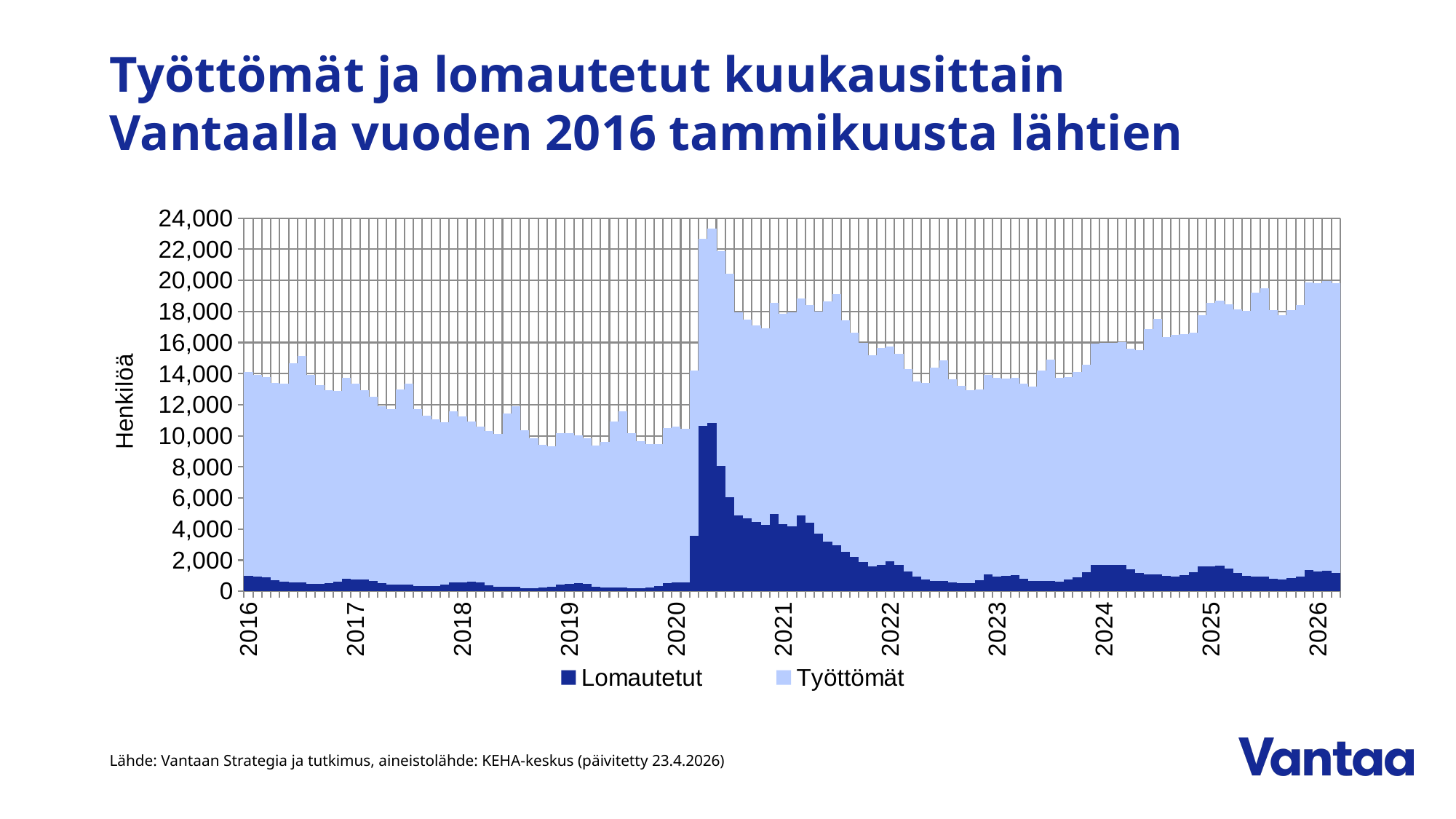
Is the value for Lomautetut during 2018 greater or less than 2,000? less What are the two series named in the legend? Lomautetut and Työttömät Is the highest total bar in 2020 greater or less than 22,000? greater Does the total of the stacked bars rise or fall from 2016 to 2019? fall Is the total bar at the start of 2026 greater or less than 18,000? greater What is the label on the vertical axis? Henkilöä Which series is larger in most months, Lomautetut or Työttömät? Työttömät In which year does the total of unemployed and laid-off people reach its highest peak? 2020 How many year labels are shown on the horizontal axis? 11 What kind of chart is shown on the slide? Stacked bar chart How many series does the legend list? 2